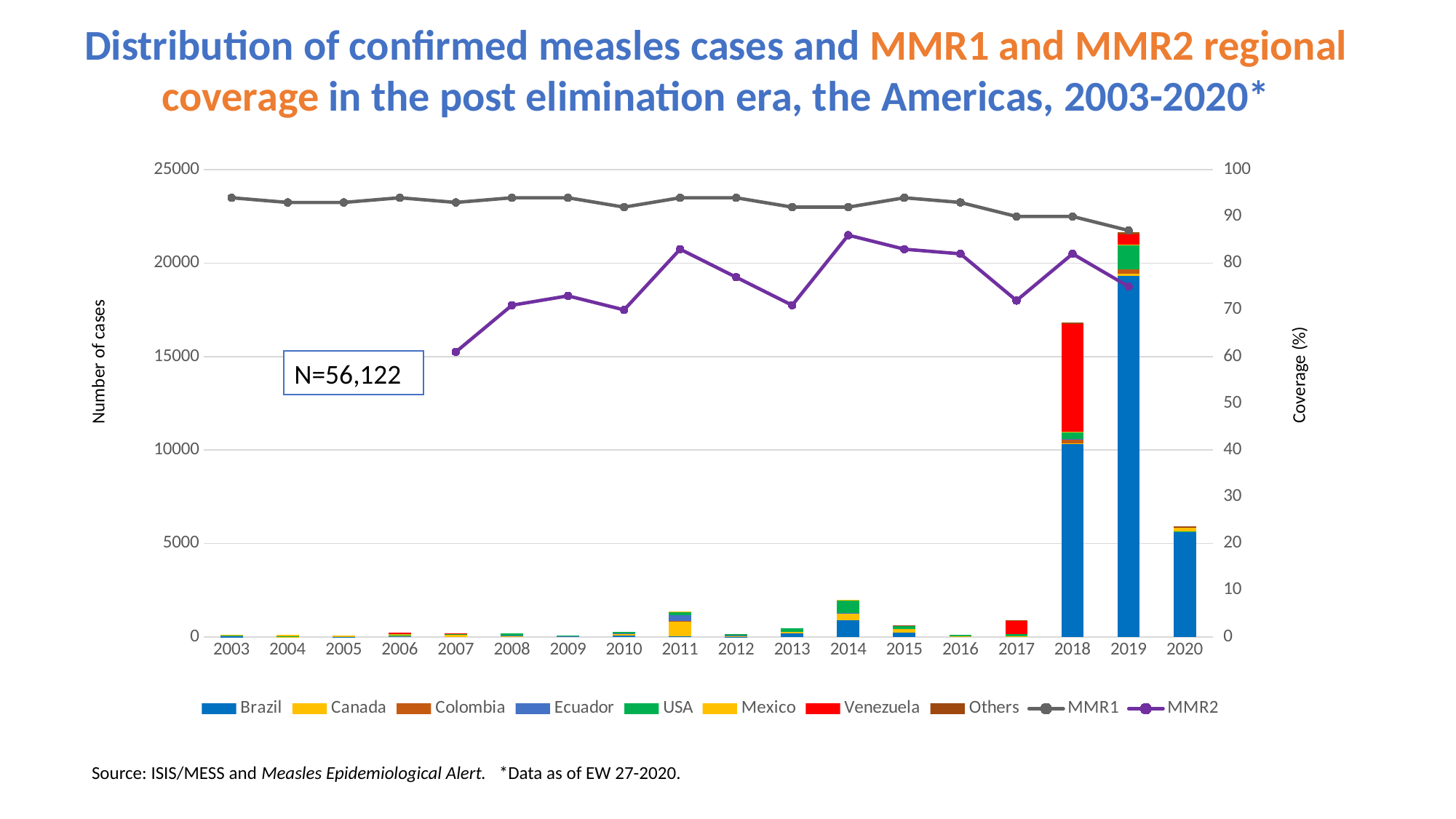
What kind of chart is shown on the slide? A combined stacked bar and line chart Is the total number of cases in 2019 greater or less than 20000? greater Does the MMR1 coverage line rise or fall from 2015 to 2019? fall Is the total number of cases in 2018 greater or less than 15000? greater In which year does the MMR2 coverage line begin? 2007 How many series does the legend list? 10 Is the total number of cases in 2020 greater or less than 10000? less What total N is shown in the text box on the chart? N=56,122 How many years are shown along the x axis? 18 Which is higher in 2010, MMR1 coverage or MMR2 coverage? MMR1 Which year has the tallest bar for number of confirmed measles cases? 2019